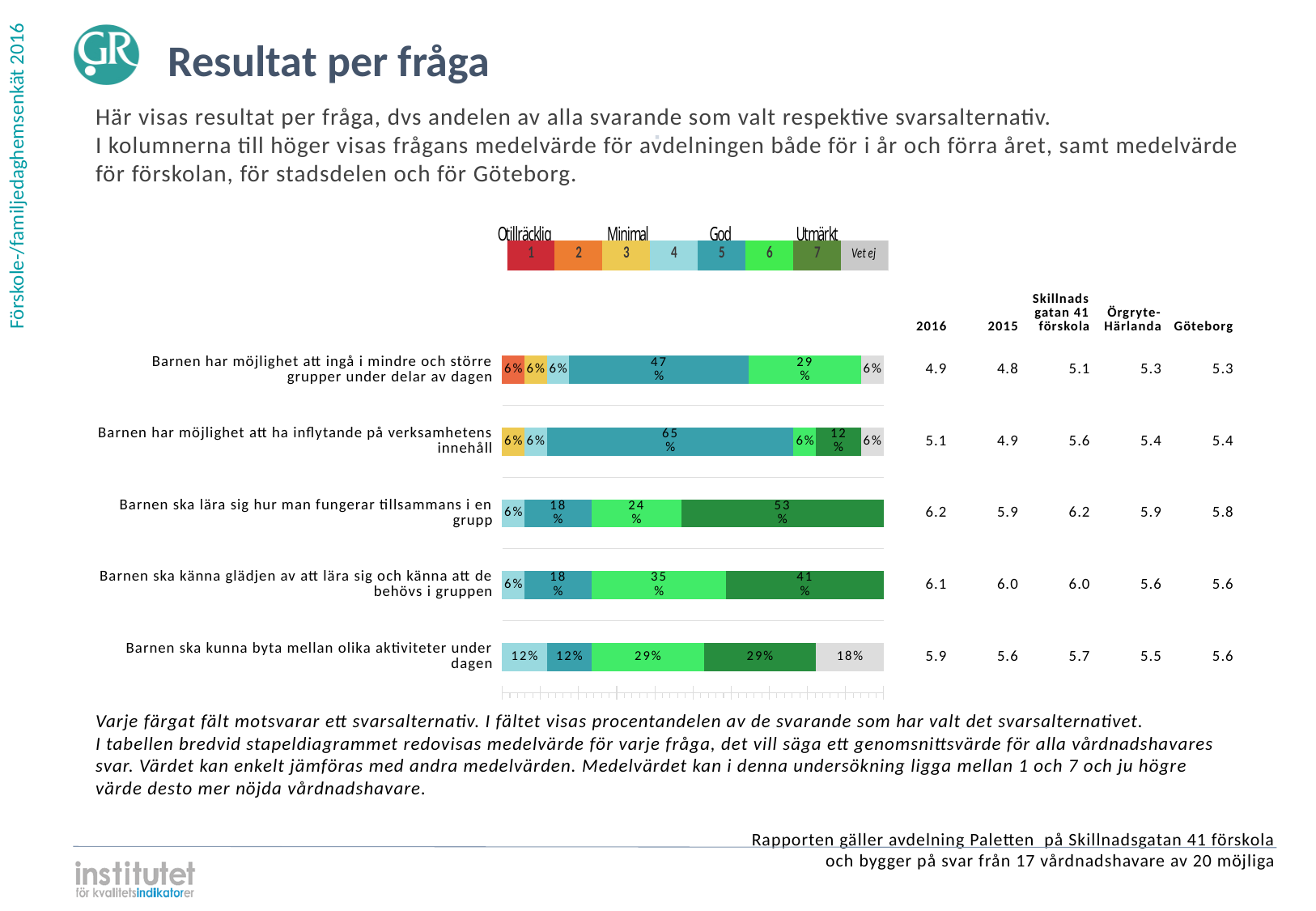
What is the difference between the alternative 6 share (35%) and the alternative 7 share (41%) for 'Barnen ska känna glädjen av att lära sig och känna att de behövs i gruppen'? 6 percentage points What percentage of respondents chose alternative 5 (God) for 'Barnen har möjlighet att ingå i mindre och större grupper under delar av dagen'? 47% What percentage chose alternative 7 (Utmärkt) for 'Barnen ska lära sig hur man fungerar tillsammans i en grupp'? 53% What is the total of all segments in the bar for 'Barnen ska kunna byta mellan olika aktiviteter under dagen'? 100% What kind of chart is shown on the slide? Stacked bar chart Which question has the largest share of respondents choosing alternative 7 (Utmärkt)? Barnen ska lära sig hur man fungerar tillsammans i en grupp What percentage answered 'Vet ej' for 'Barnen ska kunna byta mellan olika aktiviteter under dagen'? 18% In the table, what is the 2016 mean value for 'Barnen ska lära sig hur man fungerar tillsammans i en grupp'? 6.2 What label does the legend give to answer alternatives 1 and 2? Otillräcklig How many questions (categories) are plotted in the bar chart? 5 For 'Barnen har möjlighet att ha inflytande på verksamhetens innehåll', which is larger: the share for alternative 5 or the share for alternative 7? Alternative 5 (65%) How many answer alternatives does the legend above the chart list? 8